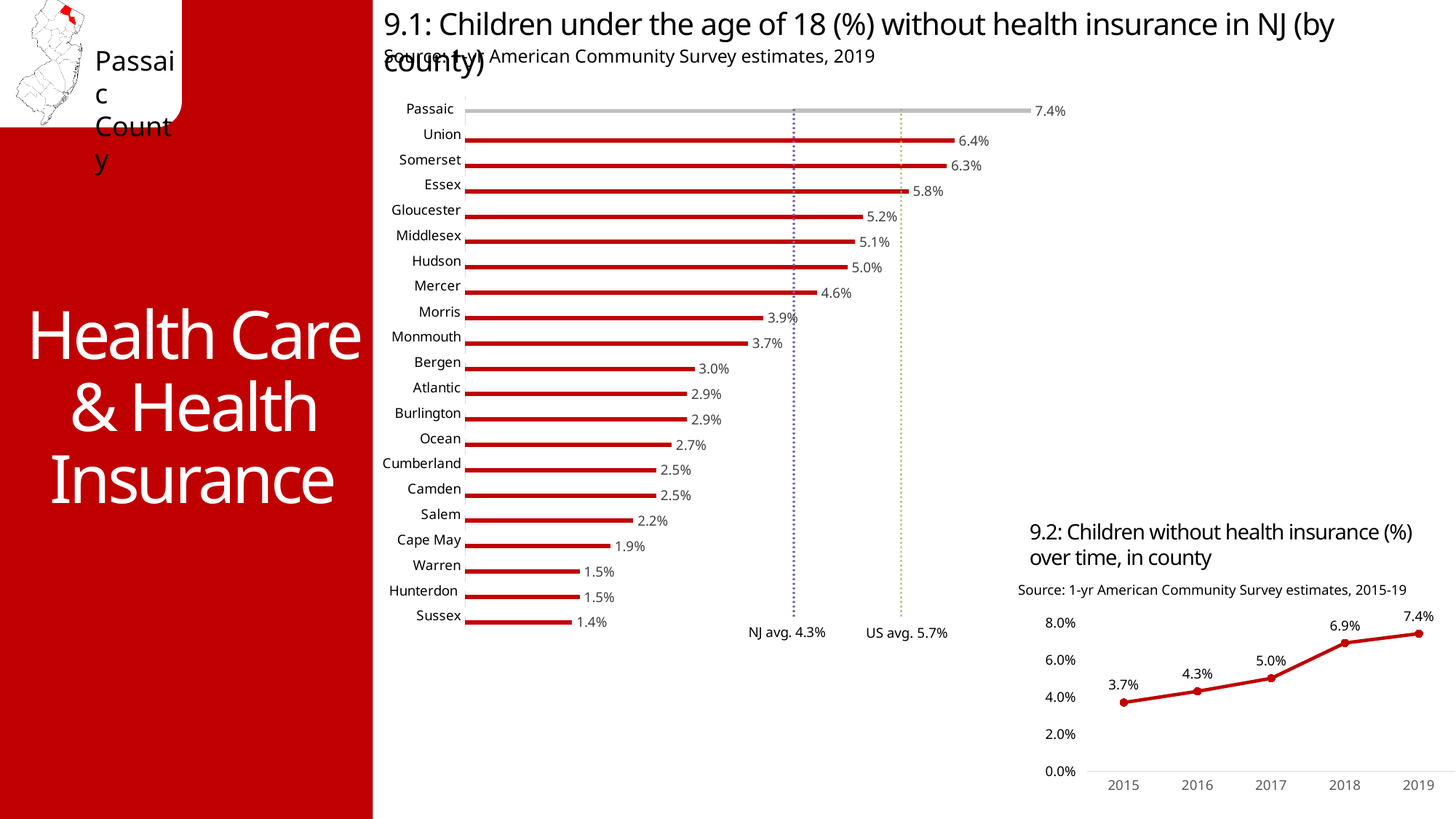
In chart 9.2, do the values rise or fall from 2015 to 2019? Rise In chart 9.1, which county has the lowest percentage of children without health insurance? Sussex In chart 9.1 (children under 18 without health insurance by county), what is the value for Passaic? 7.4% In chart 9.1, which county has a higher value, Essex or Mercer? Essex What kind of chart is chart 9.1? Bar chart In chart 9.1, which county has the highest percentage of children without health insurance? Passaic In chart 9.1, what is the difference between the values for Union and Sussex? 5.0% In chart 9.2 (children without health insurance over time), what is the value for 2017? 5.0% In chart 9.2, what is the difference between the 2019 and 2015 values? 3.7% In chart 9.1, what is the NJ average shown by the dotted reference line? 4.3% In chart 9.1, what is the value for Hudson? 5.0% In chart 9.1, how many counties are shown? 21